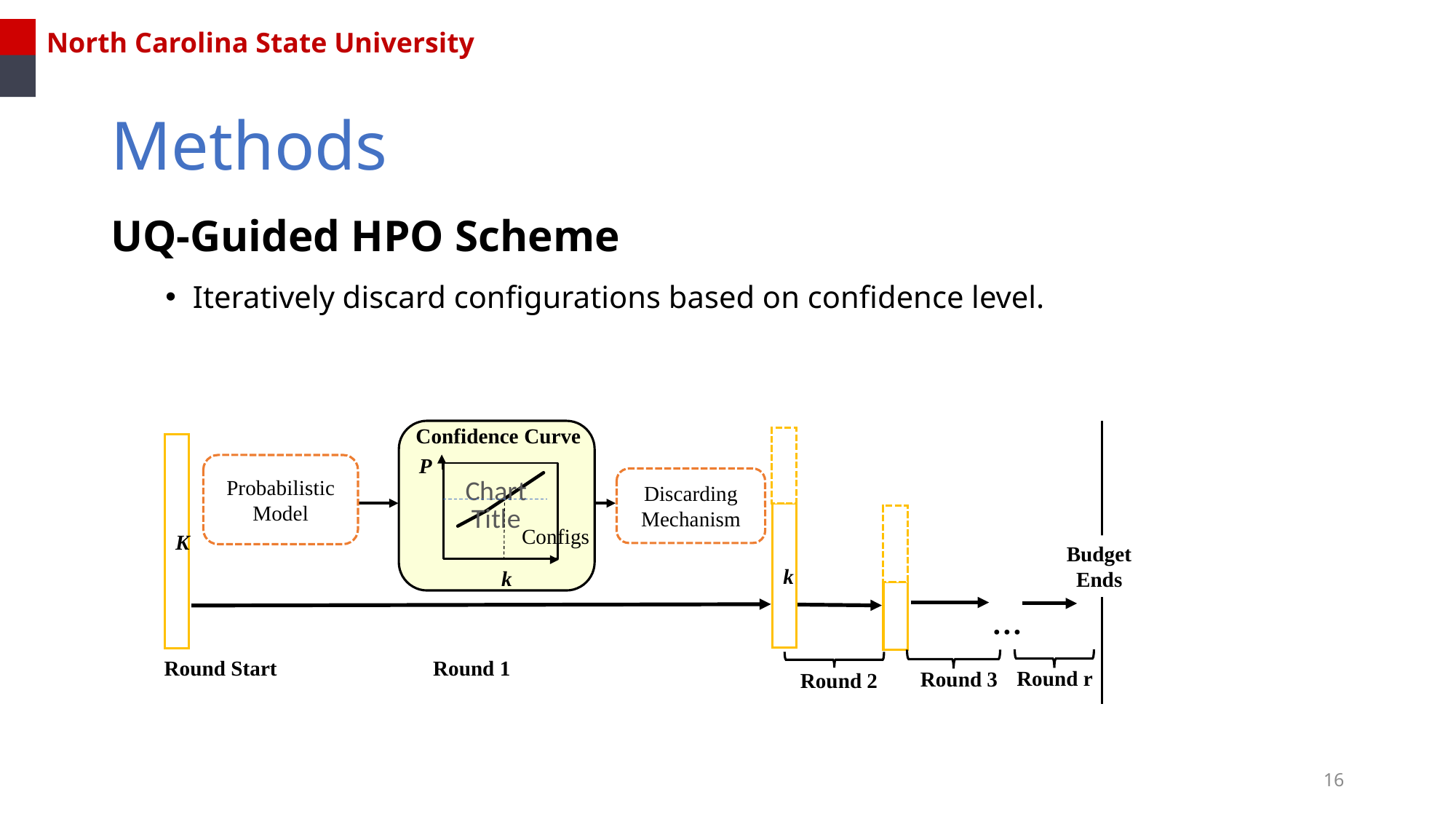
What label is on the vertical axis of the "Confidence Curve" chart? P What label is on the horizontal axis of the "Confidence Curve" chart? k What kind of chart is shown inside the "Confidence Curve" box? line chart In the "Confidence Curve" chart, does the plotted line rise or fall as k increases along the x axis? rise